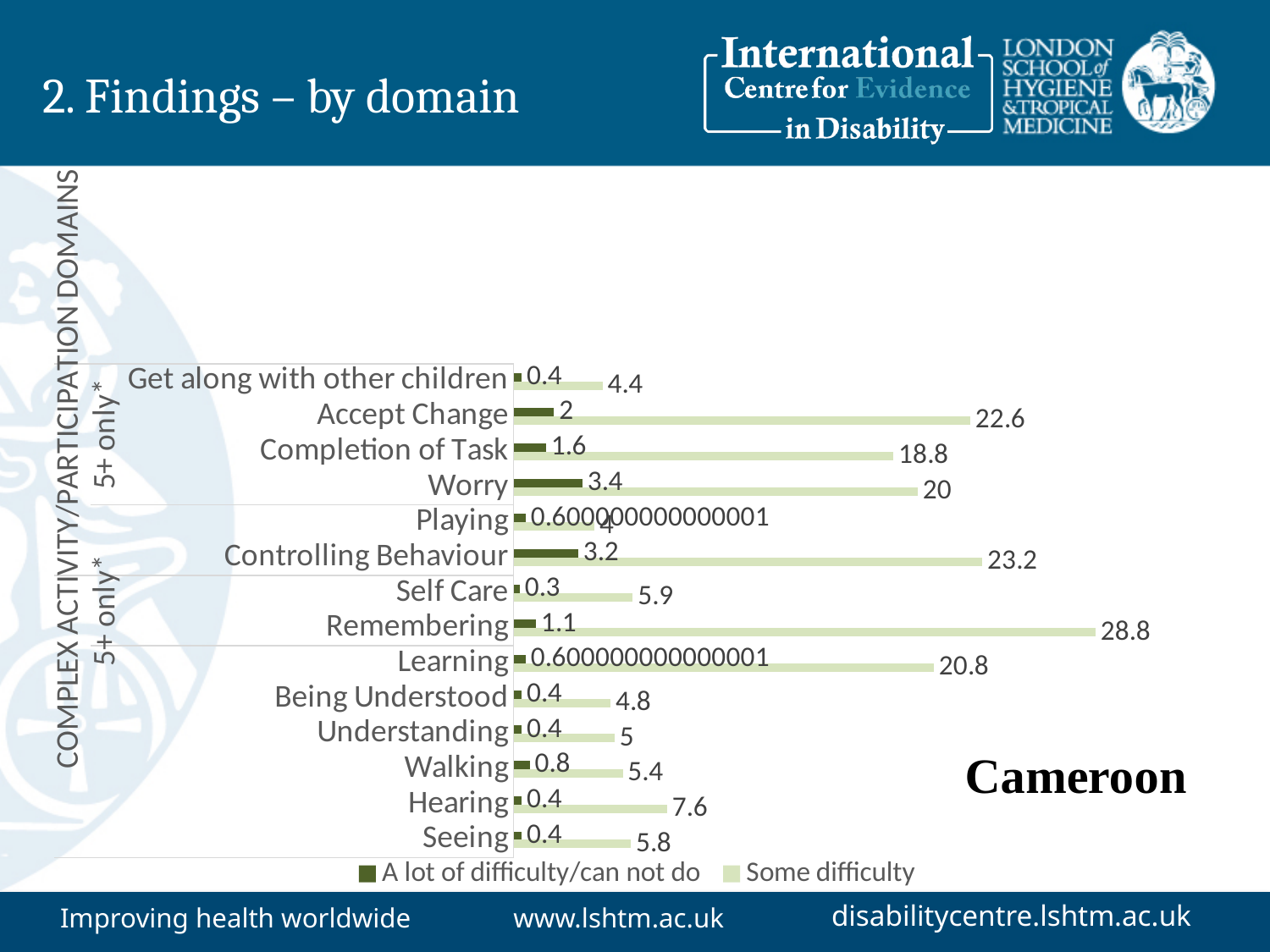
Which domain has the lowest 'A lot of difficulty/can not do' value? Self Care What is the 'Some difficulty' value for Remembering? 28.8 What is the 'Some difficulty' value for Controlling Behaviour? 23.2 Which domain has the highest 'Some difficulty' value? Remembering Which domain has the highest 'A lot of difficulty/can not do' value? Worry What kind of chart is shown on the slide? bar chart Which country does the chart refer to, according to the label on the slide? Cameroon How many series does the legend list? 2 What is the difference between the 'Some difficulty' values for Accept Change and Completion of Task? 3.8 Which has a larger 'Some difficulty' value, Hearing or Seeing? Hearing How many domains (categories) are plotted in the chart? 14 What is the 'A lot of difficulty/can not do' value for Worry? 3.4